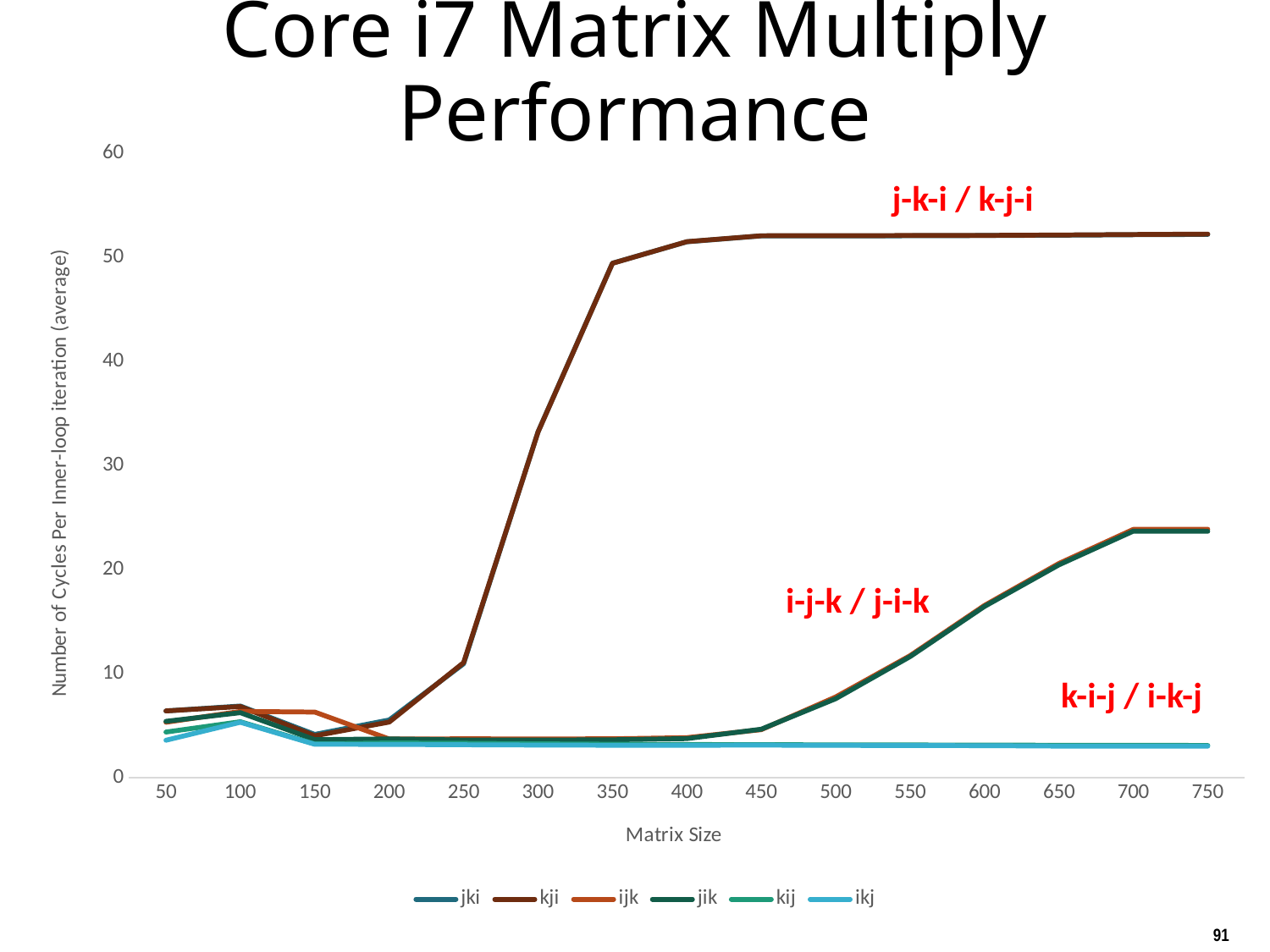
Does the kji series rise or fall overall as matrix size increases from 50 to 750? rise Is the value for kji at matrix size 250 greater or less than 20? less Is the value for kji at matrix size 350 greater or less than 40? greater Is the value for kji at matrix size 750 greater or less than 40? greater What kind of chart is shown on the slide? line chart What is the title of the chart? Core i7 Matrix Multiply Performance At matrix size 750, which series has the larger value, kji or ikj? kji How many matrix size values are plotted along the x axis? 15 What is the label of the y axis? Number of Cycles Per Inner-loop iteration (average) How many series does the legend list? 6